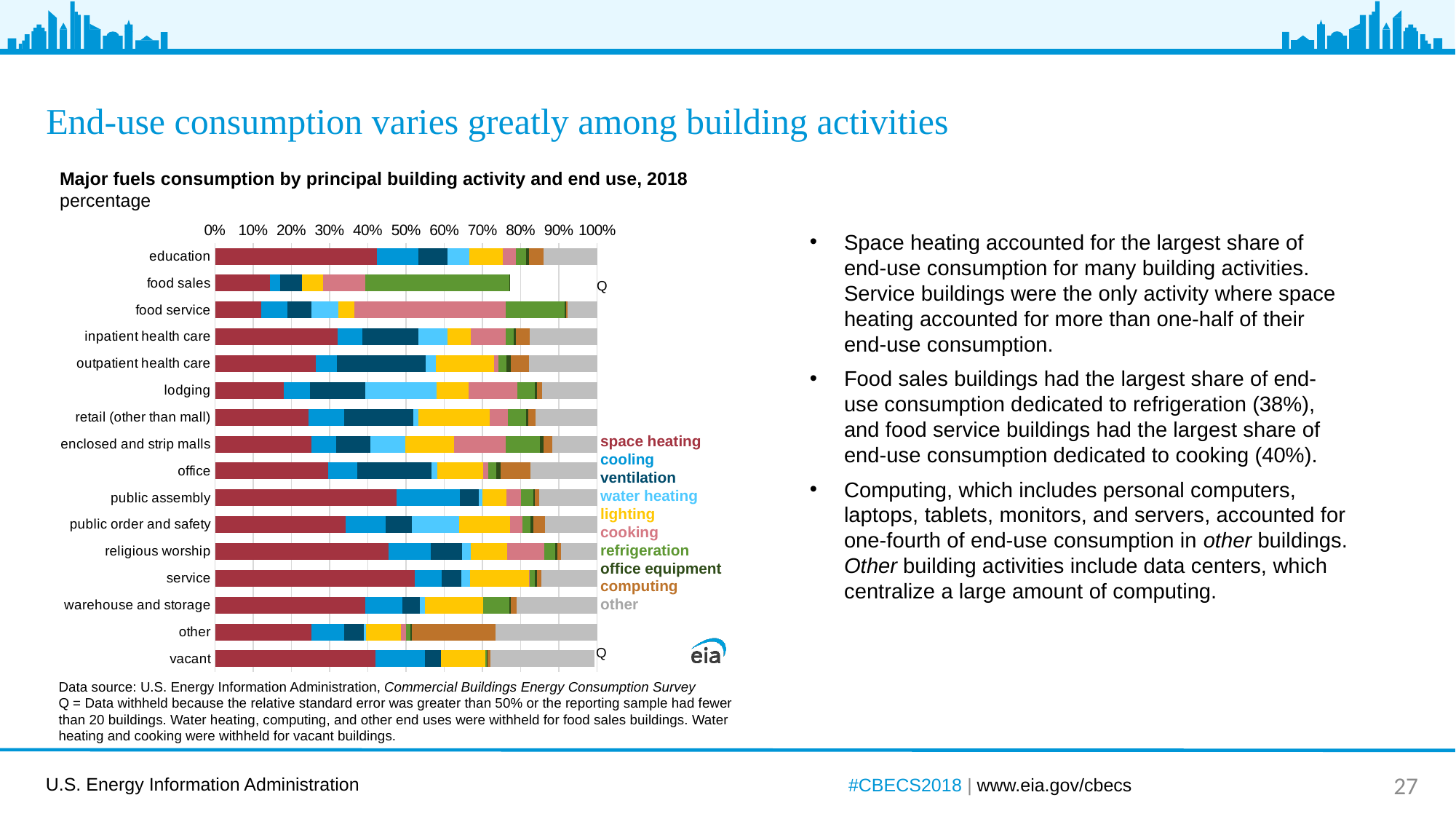
How many end-use series does the chart legend list? 10 Which two building activities are marked with a Q for withheld data on the chart? food sales and vacant Is the space heating share for food service buildings greater or less than 20%? less Which has a larger space heating share: service buildings or food sales buildings? service How many building activity categories are plotted on the chart? 16 Which building activity has the largest share of end-use consumption from space heating? service Which building activity has the largest share of end-use consumption from computing? other Which building activity has the largest share of end-use consumption from cooking? food service Is the space heating share for service buildings greater or less than 50%? greater Is the space heating share for public assembly buildings greater or less than 40%? greater What type of chart is shown on the slide? Stacked bar chart